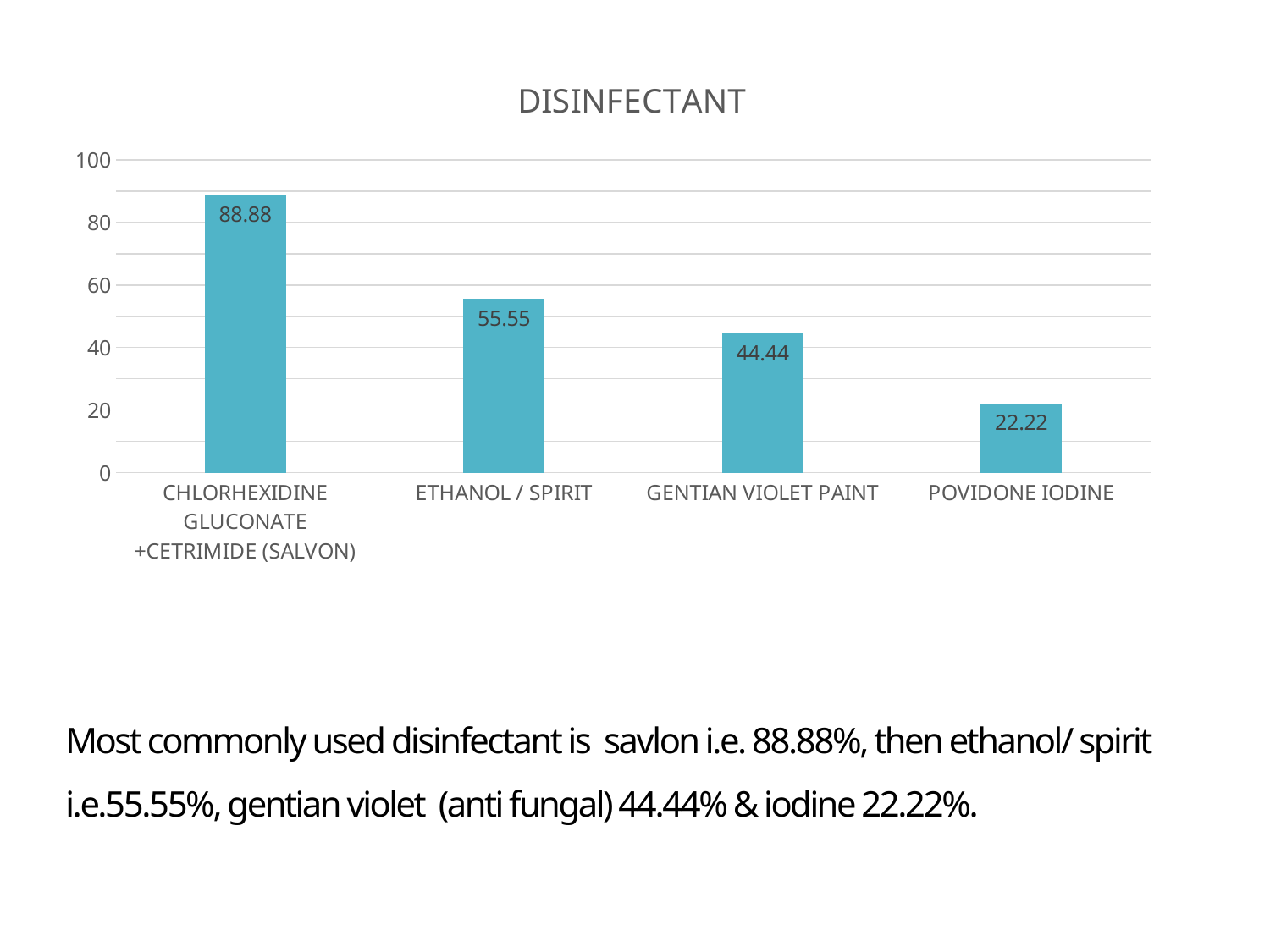
What is the value for GENTIAN VIOLET PAINT? 44.44 What is the difference between the values for GENTIAN VIOLET PAINT and POVIDONE IODINE? 22.22 Which category has the highest value? CHLORHEXIDINE GLUCONATE +CETRIMIDE (SALVON) What is the value for POVIDONE IODINE? 22.22 What is the value for ETHANOL / SPIRIT? 55.55 Which category has the lowest value? POVIDONE IODINE What kind of chart is shown on the slide? bar chart What is the difference between the values for CHLORHEXIDINE GLUCONATE +CETRIMIDE (SALVON) and ETHANOL / SPIRIT? 33.33 How many categories are shown on the x axis? 4 What is the title of the chart? DISINFECTANT Which is larger, the value for ETHANOL / SPIRIT or the value for GENTIAN VIOLET PAINT? ETHANOL / SPIRIT Is the value for GENTIAN VIOLET PAINT greater or less than 60? less